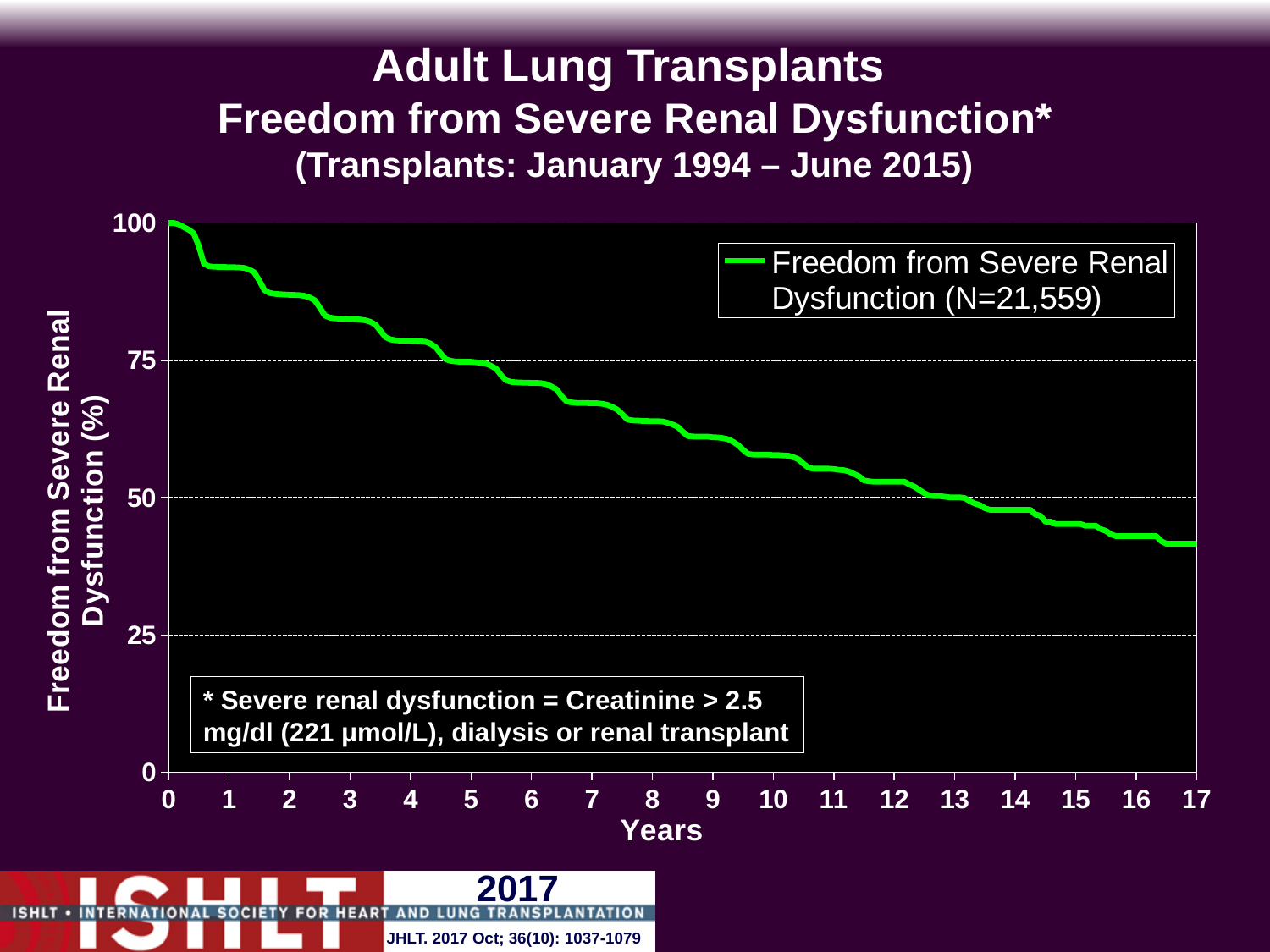
What is the freedom from severe renal dysfunction (%) at year 0? 100 How many series does the legend list? 1 Is the freedom from severe renal dysfunction at year 6 greater or less than 75? less Does the freedom from severe renal dysfunction rise or fall as years increase? fall What kind of chart is shown on the slide? line chart What is the legend entry for the plotted line? Freedom from Severe Renal Dysfunction (N=21,559) Is the freedom from severe renal dysfunction at year 2 greater or less than 75? greater Is the freedom from severe renal dysfunction at year 10 greater or less than 50? greater What is the N given in the legend for the Freedom from Severe Renal Dysfunction series? 21,559